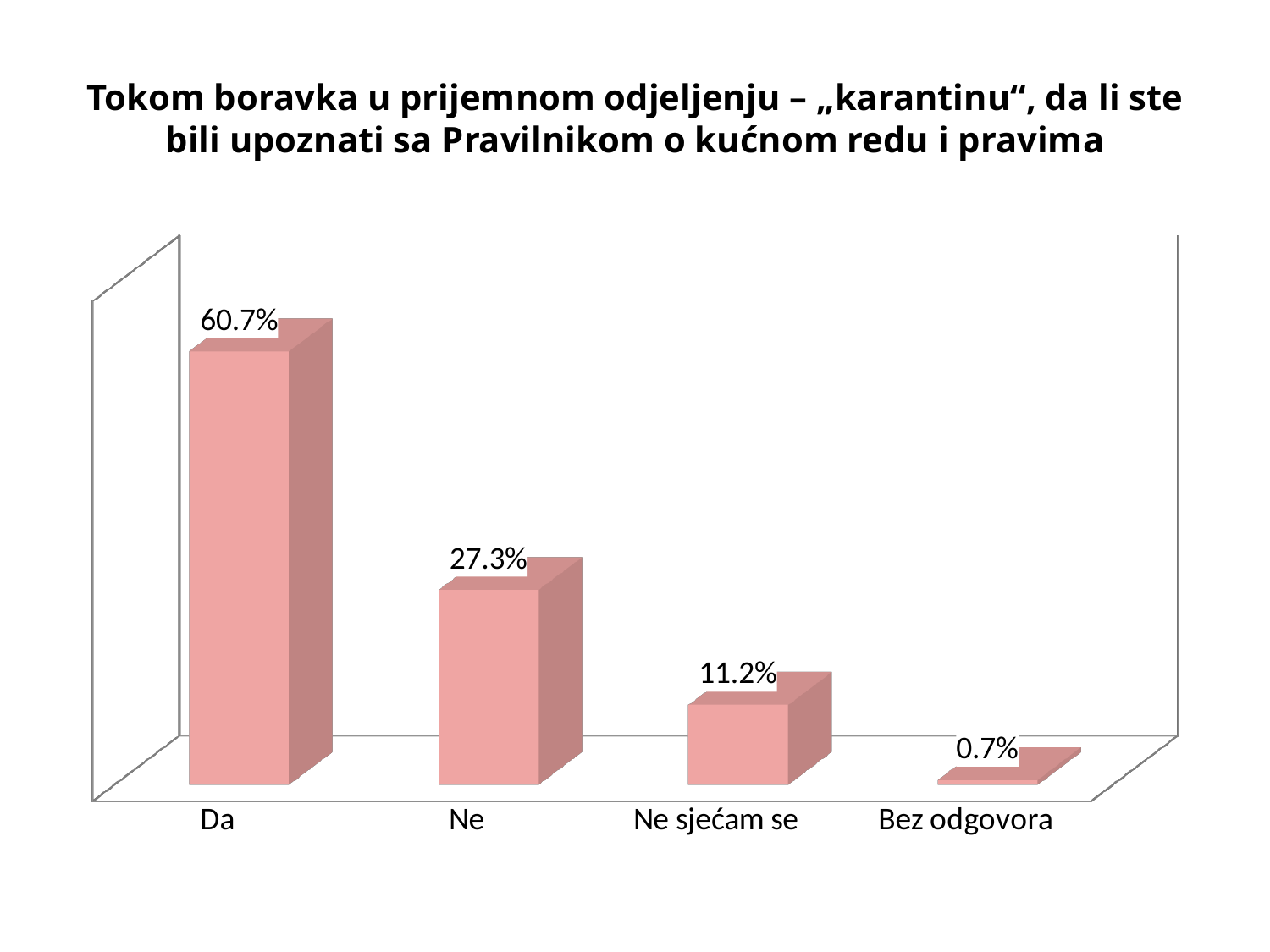
What is the value for "Ne sjećam se"? 11.2% What is the value for "Ne"? 27.3% What kind of chart is shown on the slide? Bar chart What is the difference between the values for "Da" and "Ne"? 33.4% What is the difference between the values for "Ne" and "Ne sjećam se"? 16.1% Which category has the highest value? Da How many categories are shown on the x axis? 4 Which is larger, the value for "Ne" or the value for "Ne sjećam se"? Ne What is the value for "Da"? 60.7% Do the values rise or fall from left to right along the x axis? Fall Which category has the lowest value? Bez odgovora What is the value for "Bez odgovora"? 0.7%